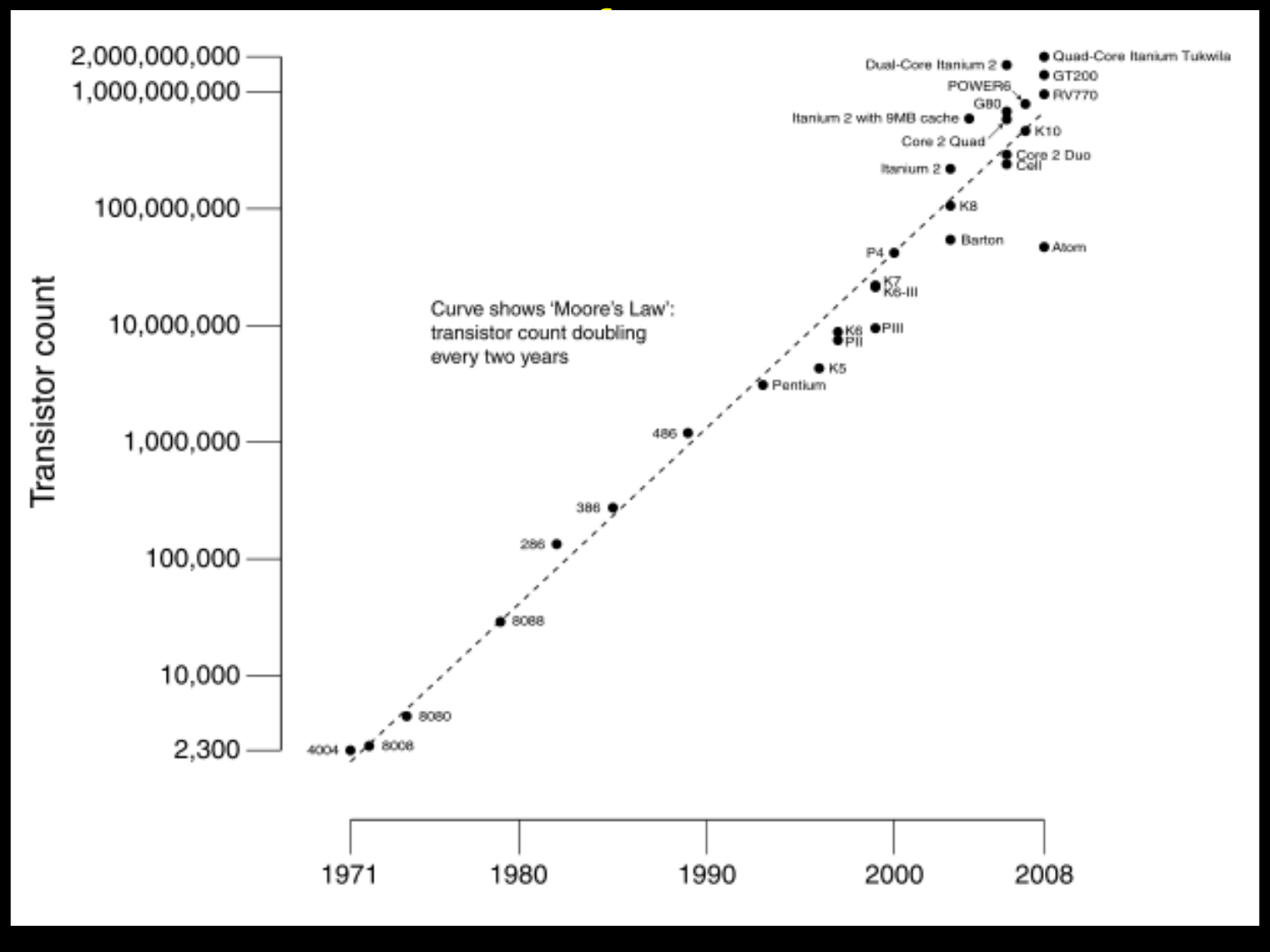
Do transistor counts rise or fall as the year increases along the x axis? rise Which processor has the lowest transistor count? 4004 Is the transistor count for the 8080 greater or less than 10,000? less Which processor has the highest transistor count? Quad-Core Itanium Tukwila What is the transistor count for the 4004? 2,300 Which has the larger transistor count, Pentium or K5? K5 Is the transistor count for Atom greater or less than 100,000,000? less Is the transistor count for K8 greater or less than 10,000,000? greater What is the label of the vertical axis? Transistor count What kind of chart is shown on the slide? scatter chart According to the annotation, what does the dashed curve show? 'Moore's Law': transistor count doubling every two years